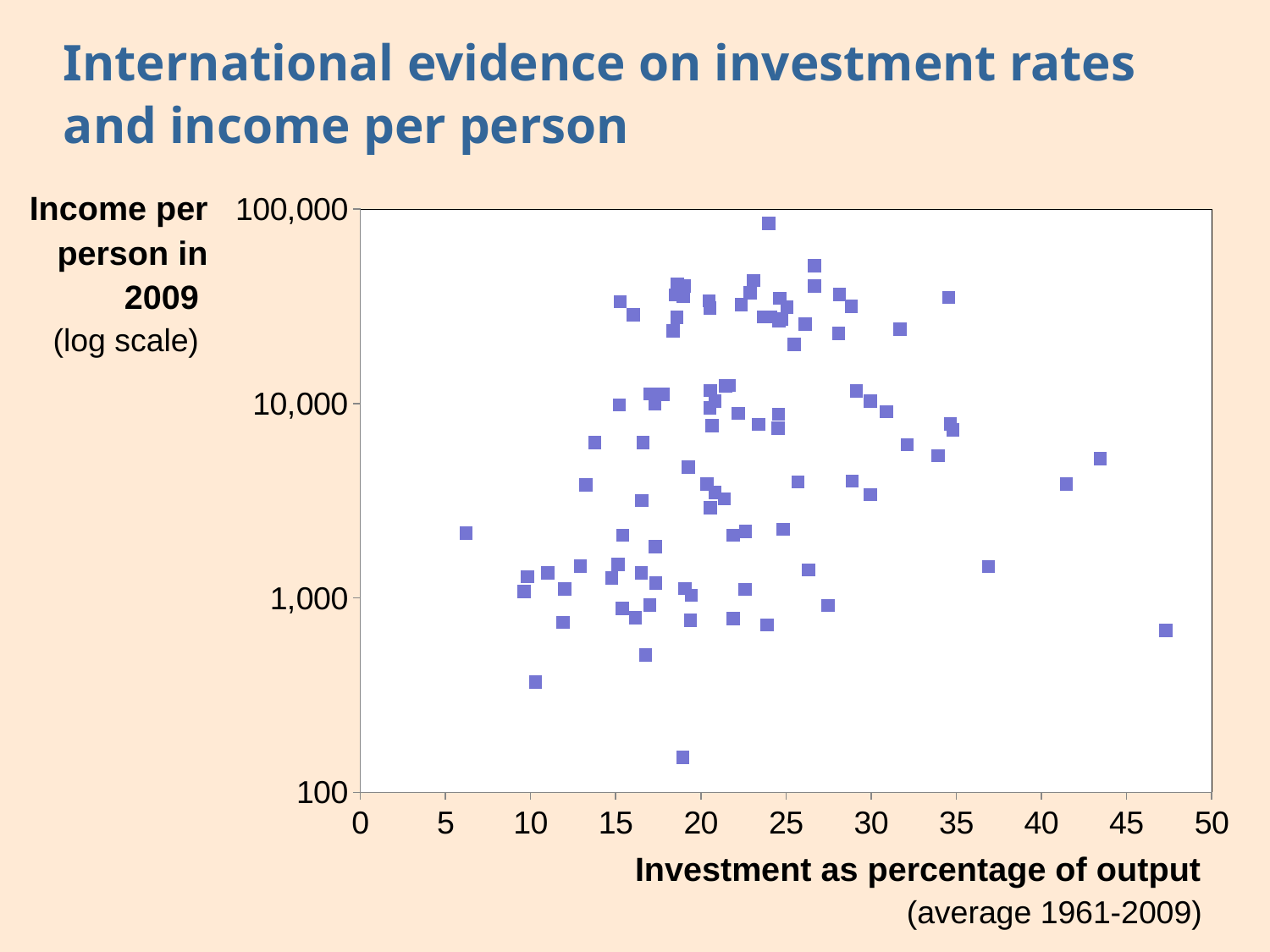
What type of scale is used on the vertical axis? log scale What is the label of the horizontal axis? Investment as percentage of output Is the investment rate of the leftmost plotted point greater or less than 10? less Is the investment rate of the point with the highest income per person greater or less than 20? greater Is the income per person of the lowest plotted point greater or less than 100? greater As investment as a percentage of output increases along the x axis, does income per person tend to rise or fall? rise What kind of chart is shown on the slide? scatter plot